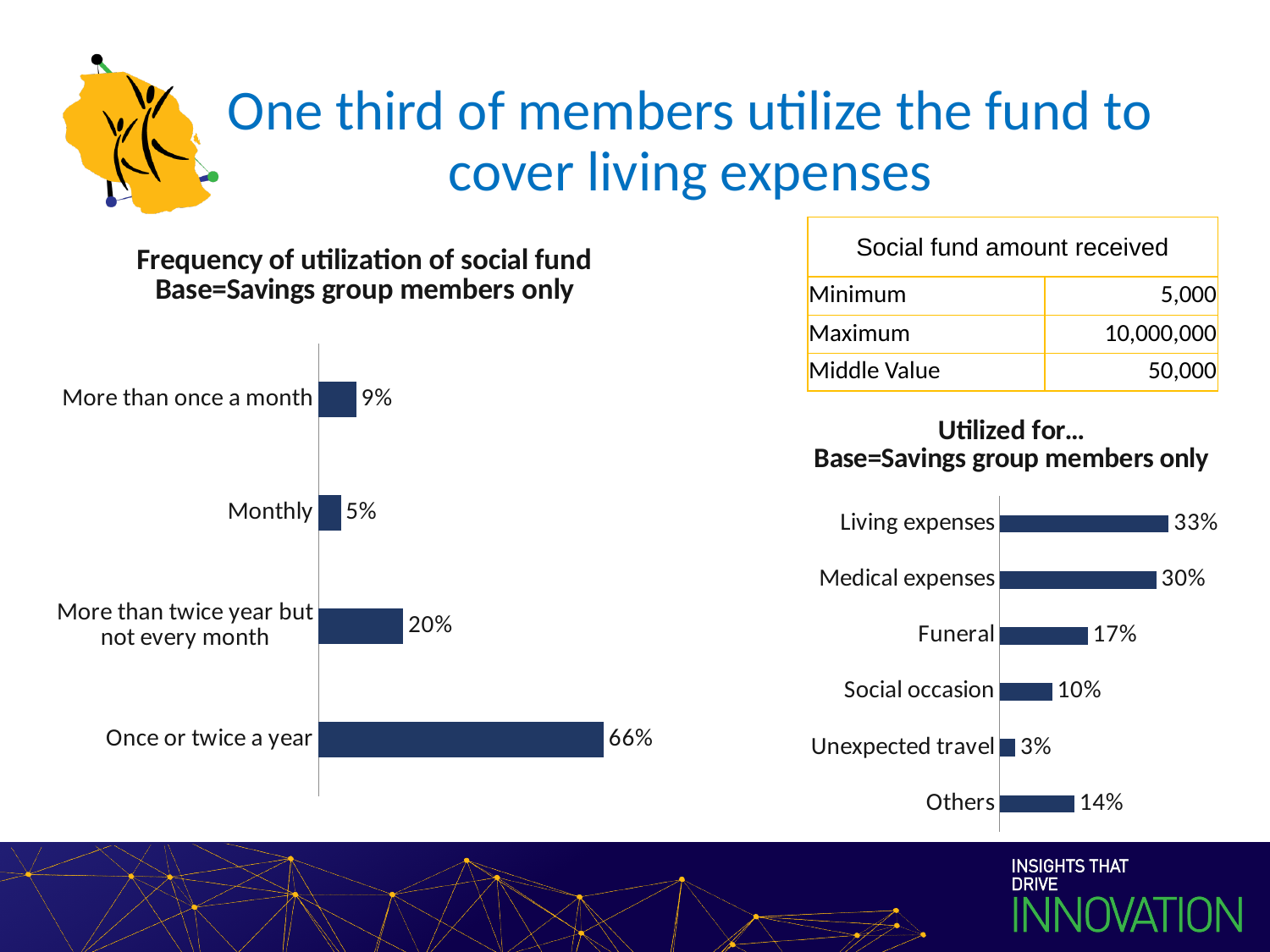
In the 'Utilized for...' chart, what is the value for 'Others'? 14% In the 'Frequency of utilization of social fund' chart, how many categories are shown? 4 In the 'Utilized for...' chart, what is the value for 'Funeral'? 17% In the 'Frequency of utilization of social fund' chart, which category has the lowest value? Monthly In the 'Frequency of utilization of social fund' chart, what is the value for 'More than twice year but not every month'? 20% What type of chart is the 'Utilized for...' chart? Bar chart In the 'Frequency of utilization of social fund' chart, what is the difference between 'Once or twice a year' and 'More than once a month'? 57% In the 'Utilized for...' chart, which is larger: 'Social occasion' or 'Others'? Others In the 'Utilized for...' chart, what is the difference between 'Living expenses' and 'Medical expenses'? 3% In the 'Utilized for...' chart, which category has the lowest value? Unexpected travel In the 'Utilized for...' chart, which category has the highest value? Living expenses In the 'Frequency of utilization of social fund' chart, what is the value for 'Once or twice a year'? 66%